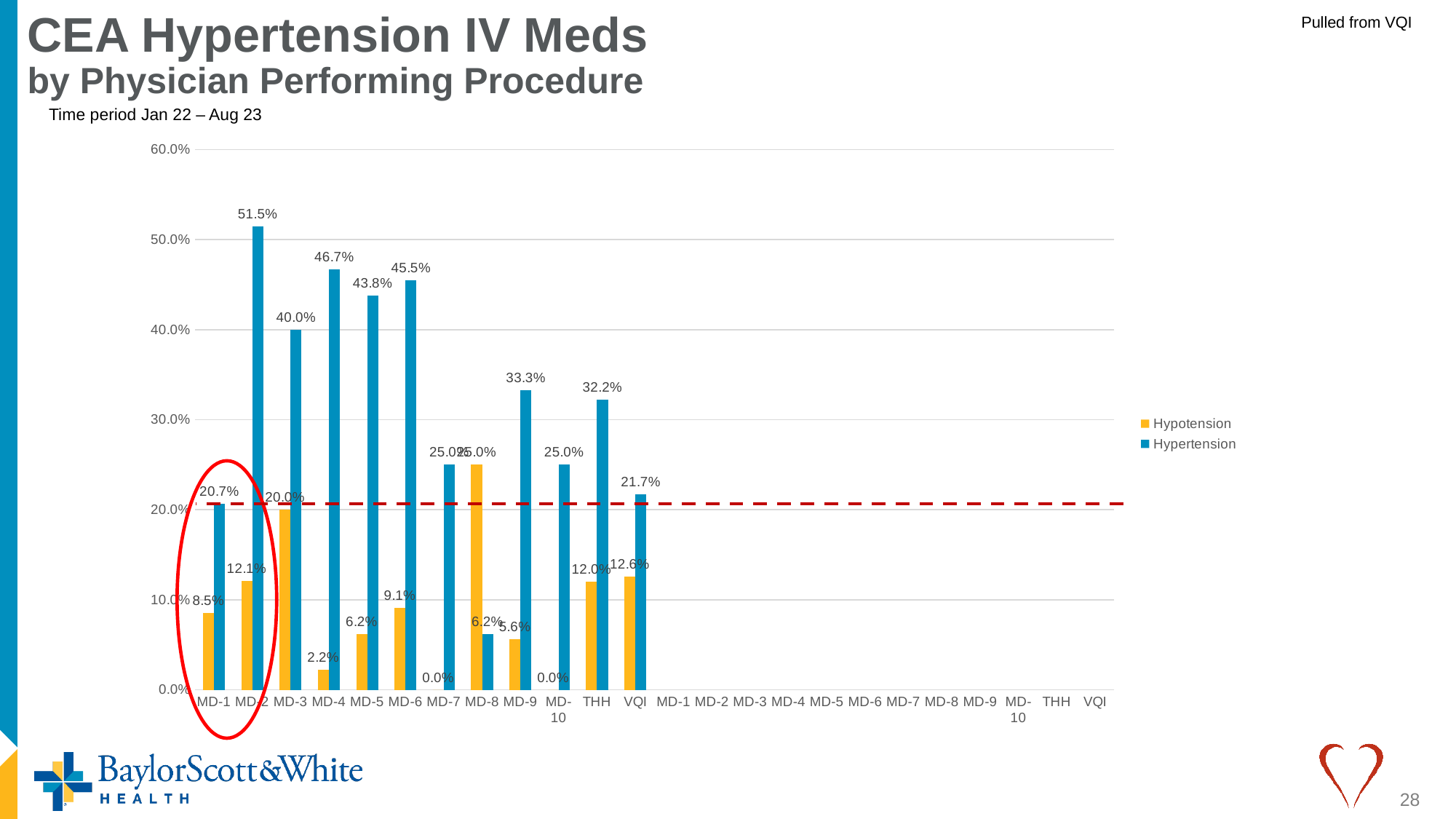
What type of chart is shown on the slide? Bar chart Which is larger, the Hypertension value for MD-9 or for THH? MD-9 Which physician has the highest Hypertension value? MD-2 Which series is shown in yellow in the legend? Hypotension What is the Hypotension value for MD-8? 25.0% What is the Hypotension value for MD-7? 0.0% What is the Hypotension value for MD-4? 2.2% What is the Hypertension value for VQI? 21.7% Which physician has the lowest Hypertension value? MD-8 What is the Hypertension value for MD-2? 51.5% What is the difference between the Hypertension values for MD-4 and MD-5? 2.9% How many series does the legend list? 2